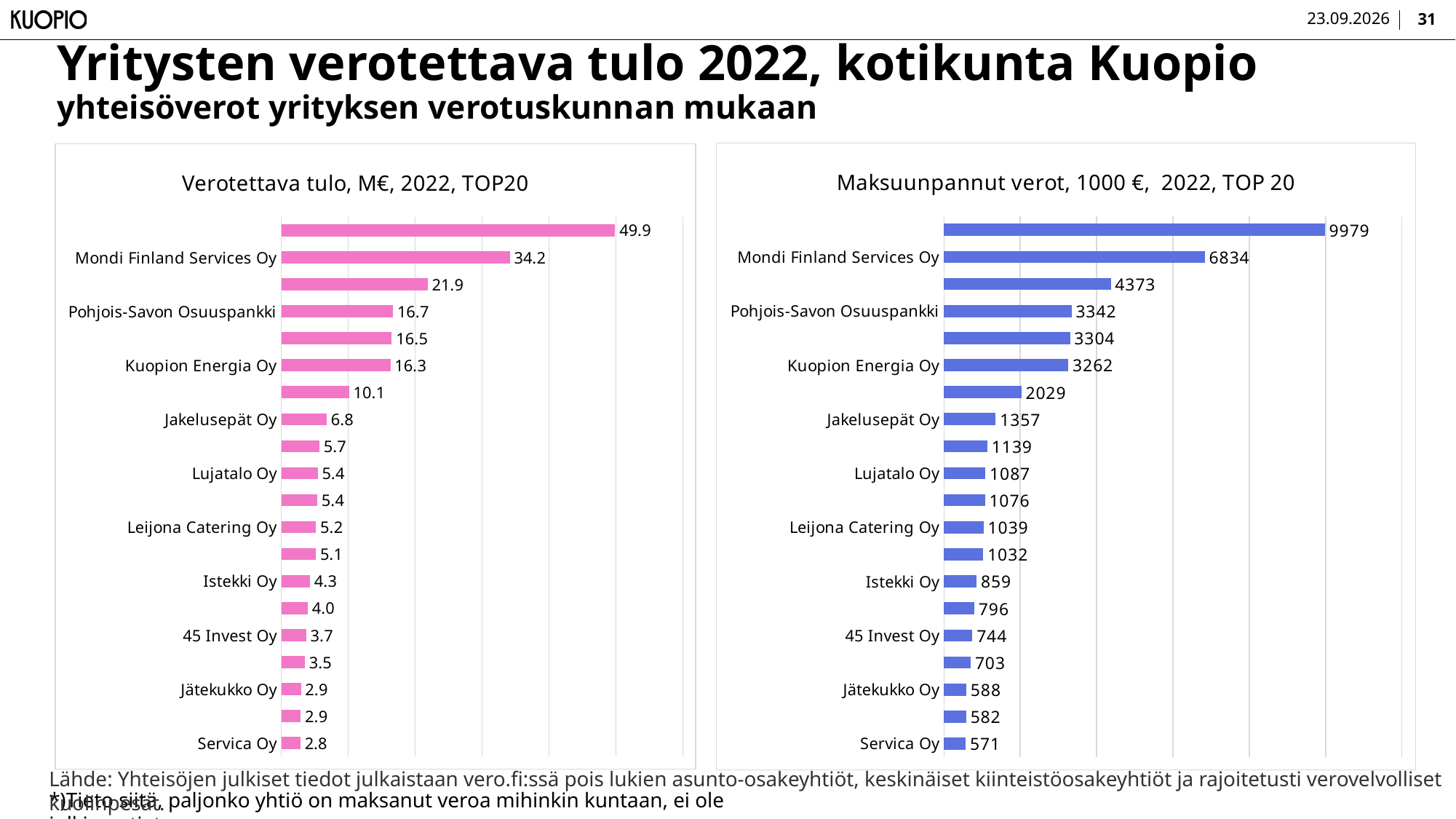
What colour are the bars in the chart titled "Verotettava tulo, M€, 2022, TOP20"? Pink In the chart titled "Verotettava tulo, M€, 2022, TOP20", what is the value for Mondi Finland Services Oy? 34.2 In the chart titled "Verotettava tulo, M€, 2022, TOP20", what is the value for Servica Oy? 2.8 In the chart titled "Verotettava tulo, M€, 2022, TOP20", what is the highest value shown? 49.9 How many bars are shown in the chart titled "Verotettava tulo, M€, 2022, TOP20"? 20 In the chart titled "Maksuunpannut verot, 1000 €, 2022, TOP 20", which labelled company has the lowest value? Servica Oy In the chart titled "Maksuunpannut verot, 1000 €, 2022, TOP 20", what is the value for Kuopion Energia Oy? 3262 What kind of chart is the chart titled "Maksuunpannut verot, 1000 €, 2022, TOP 20"? Bar chart In the chart titled "Verotettava tulo, M€, 2022, TOP20", what is the difference between Mondi Finland Services Oy and Pohjois-Savon Osuuspankki? 17.5 In the chart titled "Maksuunpannut verot, 1000 €, 2022, TOP 20", what is the value for Jakelusepät Oy? 1357 In the chart titled "Maksuunpannut verot, 1000 €, 2022, TOP 20", what is the difference between Pohjois-Savon Osuuspankki and Kuopion Energia Oy? 80 In the chart titled "Maksuunpannut verot, 1000 €, 2022, TOP 20", which is larger, Lujatalo Oy or Leijona Catering Oy? Lujatalo Oy